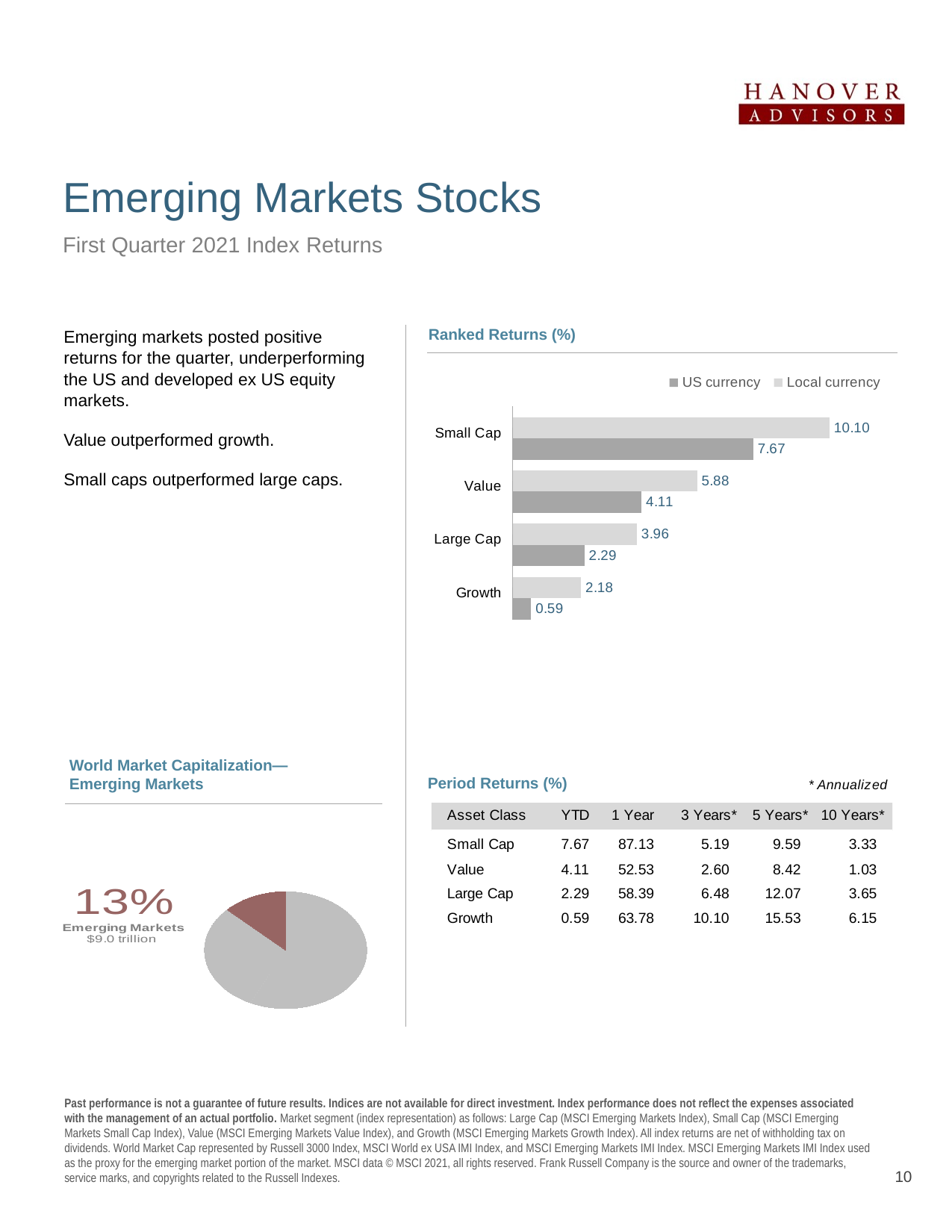
What kind of chart is the World Market Capitalization—Emerging Markets chart? Pie chart In the Ranked Returns (%) chart, which category has the lowest US currency return? Growth In the Ranked Returns (%) chart, which is larger: the US currency return for Value or the Local currency return for Large Cap? US currency return for Value In the Ranked Returns (%) chart, what is the US currency return for Growth? 0.59 In the World Market Capitalization—Emerging Markets chart, what share of world market capitalization do Emerging Markets represent? 13% In the Ranked Returns (%) chart, what is the US currency return for Small Cap? 7.67 What kind of chart is the Ranked Returns (%) chart? Bar chart How many categories are shown in the Ranked Returns (%) chart? 4 In the Ranked Returns (%) chart, what is the difference between the Local currency and US currency returns for Large Cap? 1.67 How many series does the legend of the Ranked Returns (%) chart list? 2 In the Ranked Returns (%) chart, which category has the highest Local currency return? Small Cap In the Ranked Returns (%) chart, what is the Local currency return for Value? 5.88